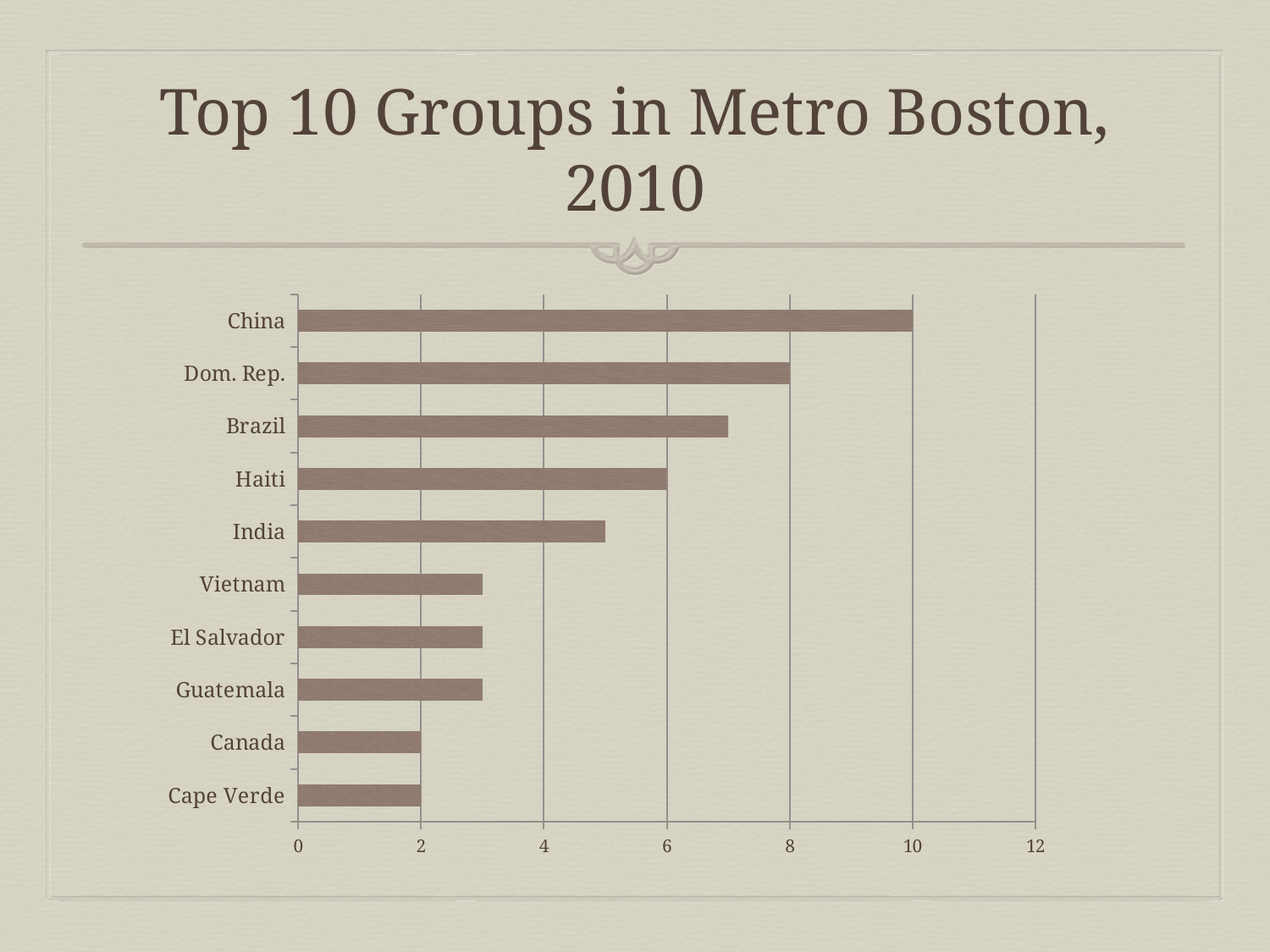
Is the value for Vietnam greater or less than 4? less What is the title of the slide? Top 10 Groups in Metro Boston, 2010 What is the value for China? 10 Which group has the highest value? China What is the difference between the values for China and Dom. Rep.? 2 Is the value for Brazil greater or less than 6? greater What is the value for Dom. Rep.? 8 What kind of chart is shown on the slide? bar chart How many groups are shown in the chart? 10 What is the value for Haiti? 6 What is the value for Canada? 2 Which has a larger value, Brazil or India? Brazil